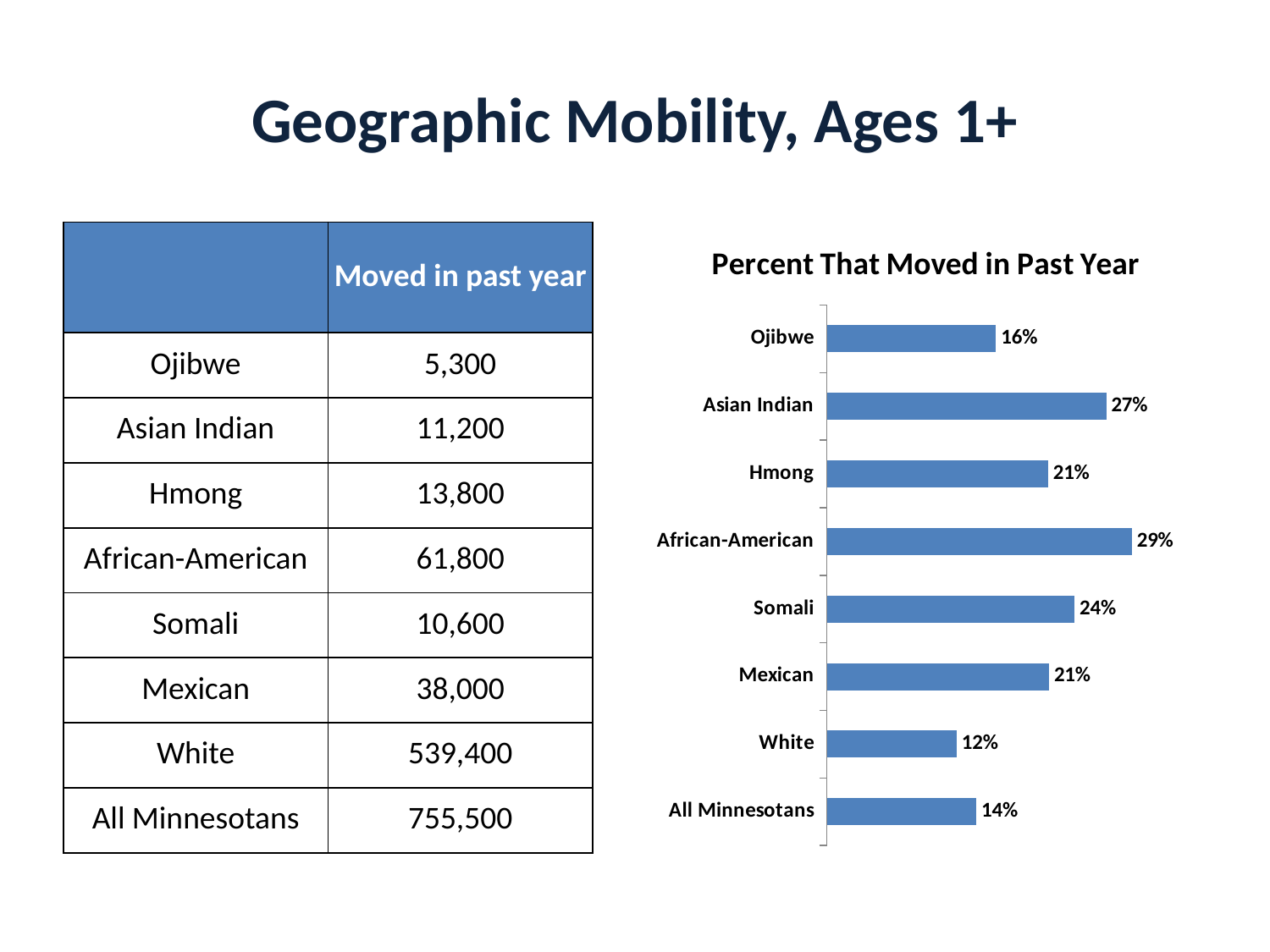
Which category has the highest value in the Percent That Moved in Past Year chart? African-American What is the value for Somali in the Percent That Moved in Past Year chart? 24% What is the difference between the Somali and Ojibwe values in the Percent That Moved in Past Year chart? 8% Which category has the lowest value in the Percent That Moved in Past Year chart? White What is the title of the chart on the slide? Percent That Moved in Past Year Which is larger in the Percent That Moved in Past Year chart, the value for Asian Indian or the value for Hmong? Asian Indian What is the difference between the Asian Indian and White values in the Percent That Moved in Past Year chart? 15% What is the value for Ojibwe in the Percent That Moved in Past Year chart? 16% What kind of chart is the Percent That Moved in Past Year chart? Bar chart What is the value for All Minnesotans in the Percent That Moved in Past Year chart? 14% What is the value for African-American in the Percent That Moved in Past Year chart? 29% How many categories are shown in the Percent That Moved in Past Year chart? 8